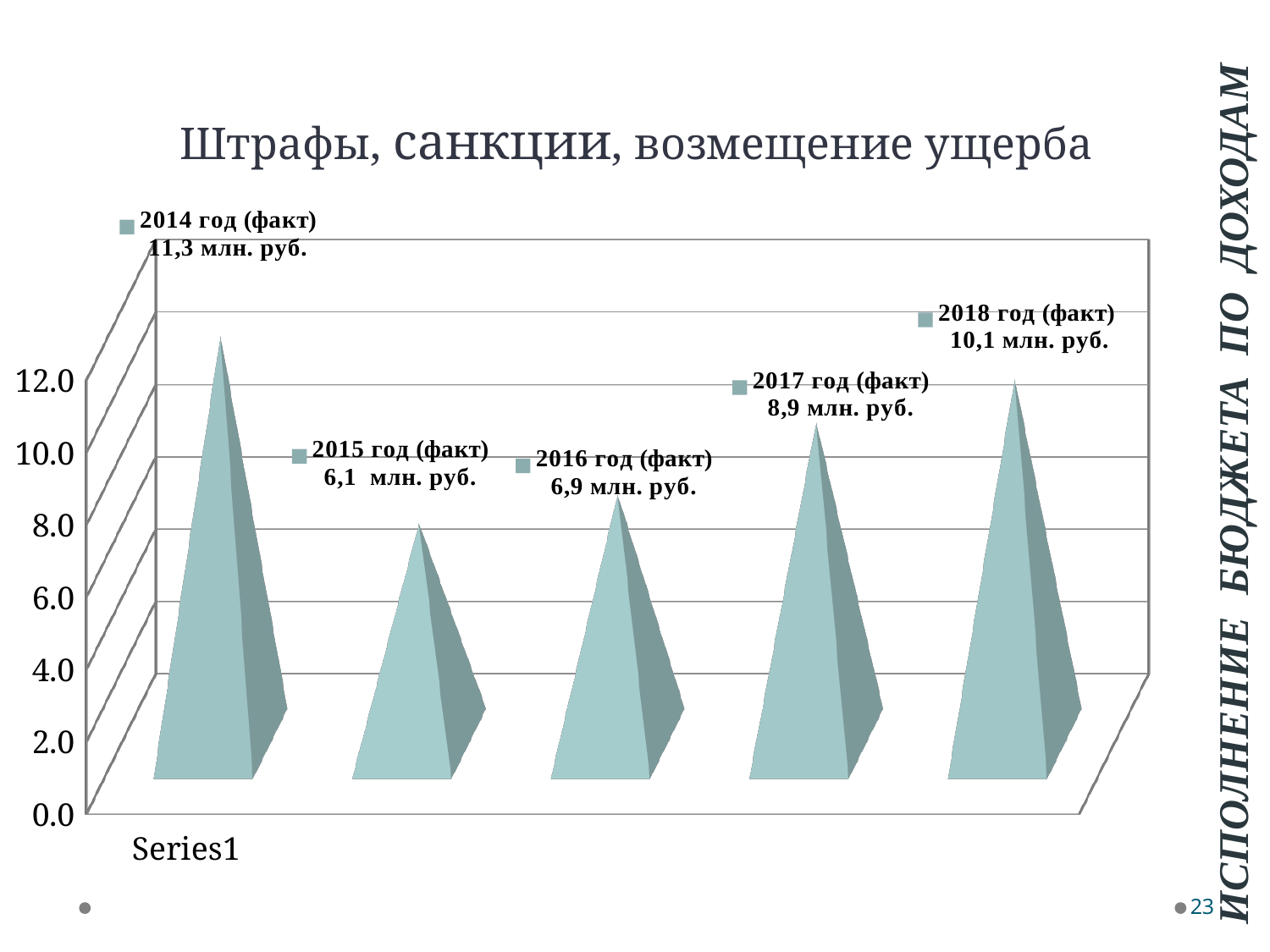
Which year has the highest value? 2014 год (факт) Which year has the lowest value? 2015 год (факт) What kind of chart is shown on the slide? bar chart What is the value for 2014 год (факт)? 11,3 млн. руб. What is the value for 2018 год (факт)? 10,1 млн. руб. What is the value for 2016 год (факт)? 6,9 млн. руб. What is the title of the chart? Штрафы, санкции, возмещение ущерба Which is larger, the value for 2016 год (факт) or 2017 год (факт)? 2017 год (факт) What is the difference between the values for 2014 год (факт) and 2015 год (факт)? 5,2 млн. руб. Is the value for 2017 год (факт) greater or less than 8.0? greater How many years are shown in the chart? 5 What is the difference between the values for 2018 год (факт) and 2017 год (факт)? 1,2 млн. руб.